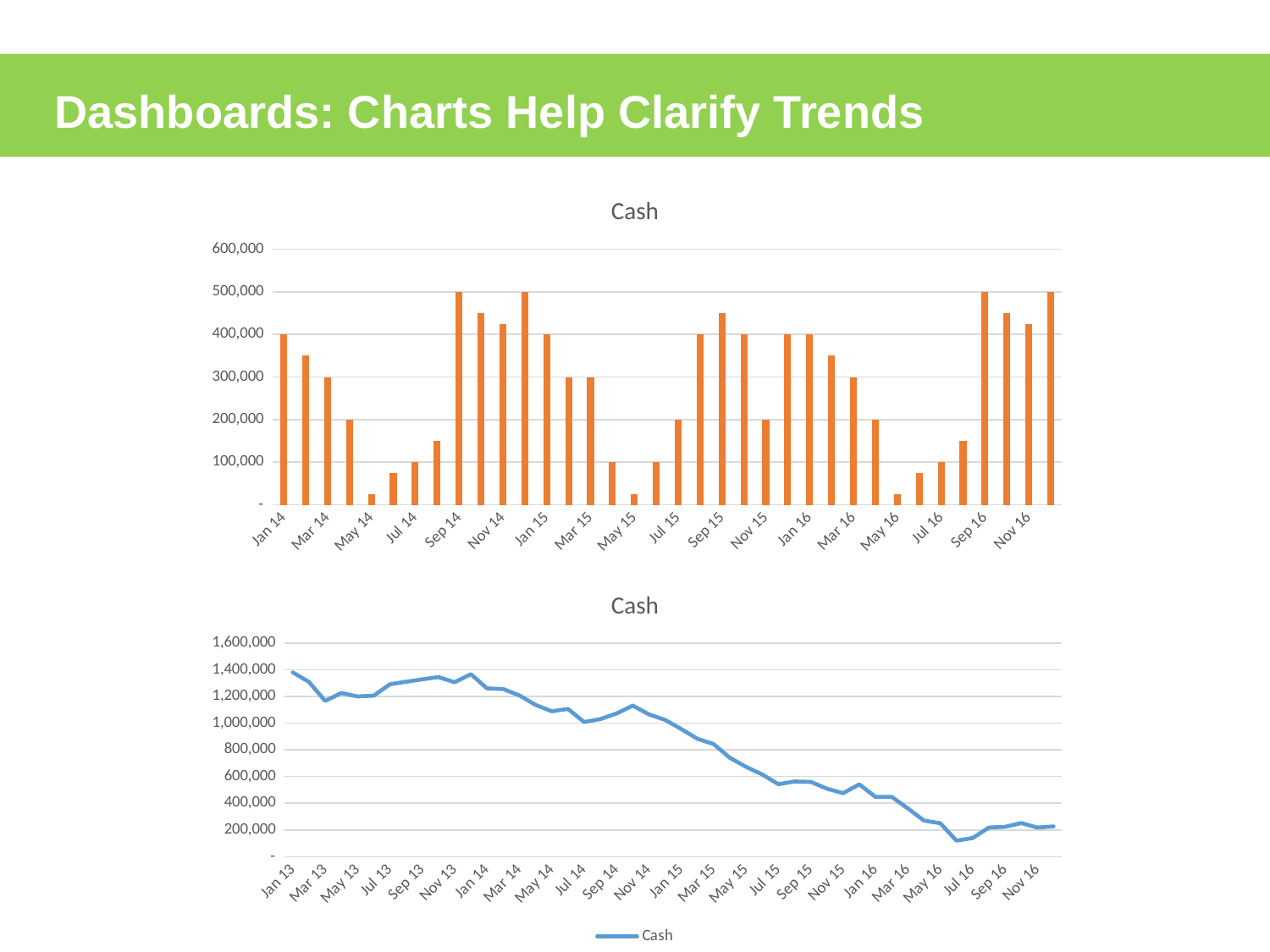
In the bottom line chart, is the value for Nov 16 greater or less than 400,000? less In the top bar chart, what is the value for Jan 14? 400,000 In the top bar chart, what is the value for Sep 16? 500,000 How many series does the legend of the bottom line chart list? 1 In the bottom line chart, do the values generally rise or fall from Jan 13 to Nov 16? fall In the top bar chart, which is larger, the value for Jan 14 or the value for Mar 14? Jan 14 In the top bar chart, is the value for May 14 greater or less than 100,000? less What type of chart is the top chart titled "Cash"? bar chart What type of chart is the bottom chart titled "Cash"? line chart In the bottom line chart, is the value for Jan 13 greater or less than 1,200,000? greater In the top bar chart, what is the value for Sep 14? 500,000